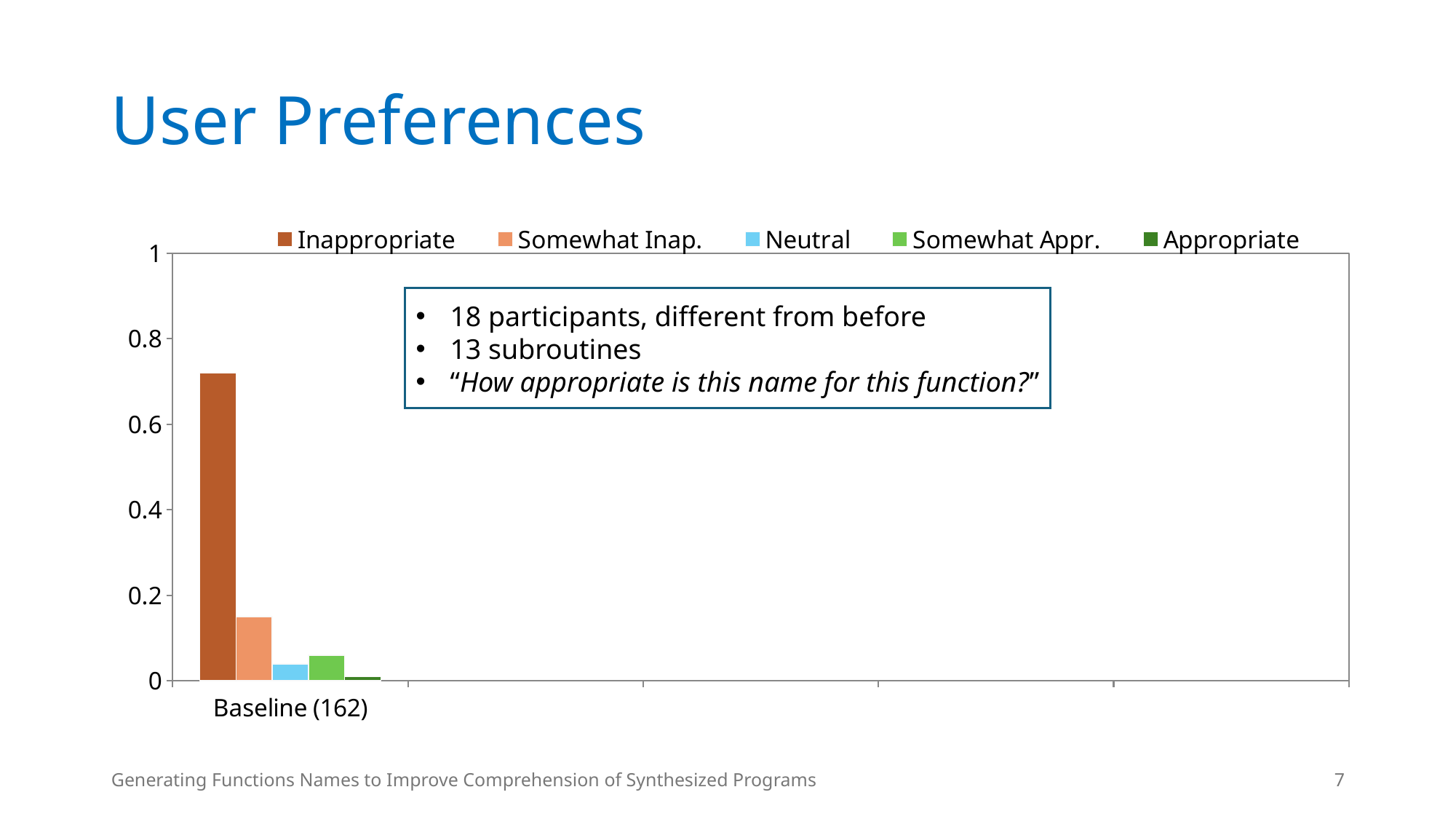
How many categories are shown on the x axis of the chart? 1 How many series does the chart's legend list? 5 What is the label of the category shown on the x axis? Baseline (162) Which is larger for Baseline (162): Somewhat Inap. or Somewhat Appr.? Somewhat Inap. What kind of chart is shown on the slide? bar chart Is the value for Inappropriate greater or less than 0.6? greater Is the value for Inappropriate greater or less than 0.8? less Which series has the highest value for Baseline (162)? Inappropriate Which is larger for Baseline (162): Inappropriate or Somewhat Inap.? Inappropriate Which series has the lowest value for Baseline (162)? Appropriate Which series is listed first in the chart's legend? Inappropriate Is the value for Somewhat Inap. greater or less than 0.2? less